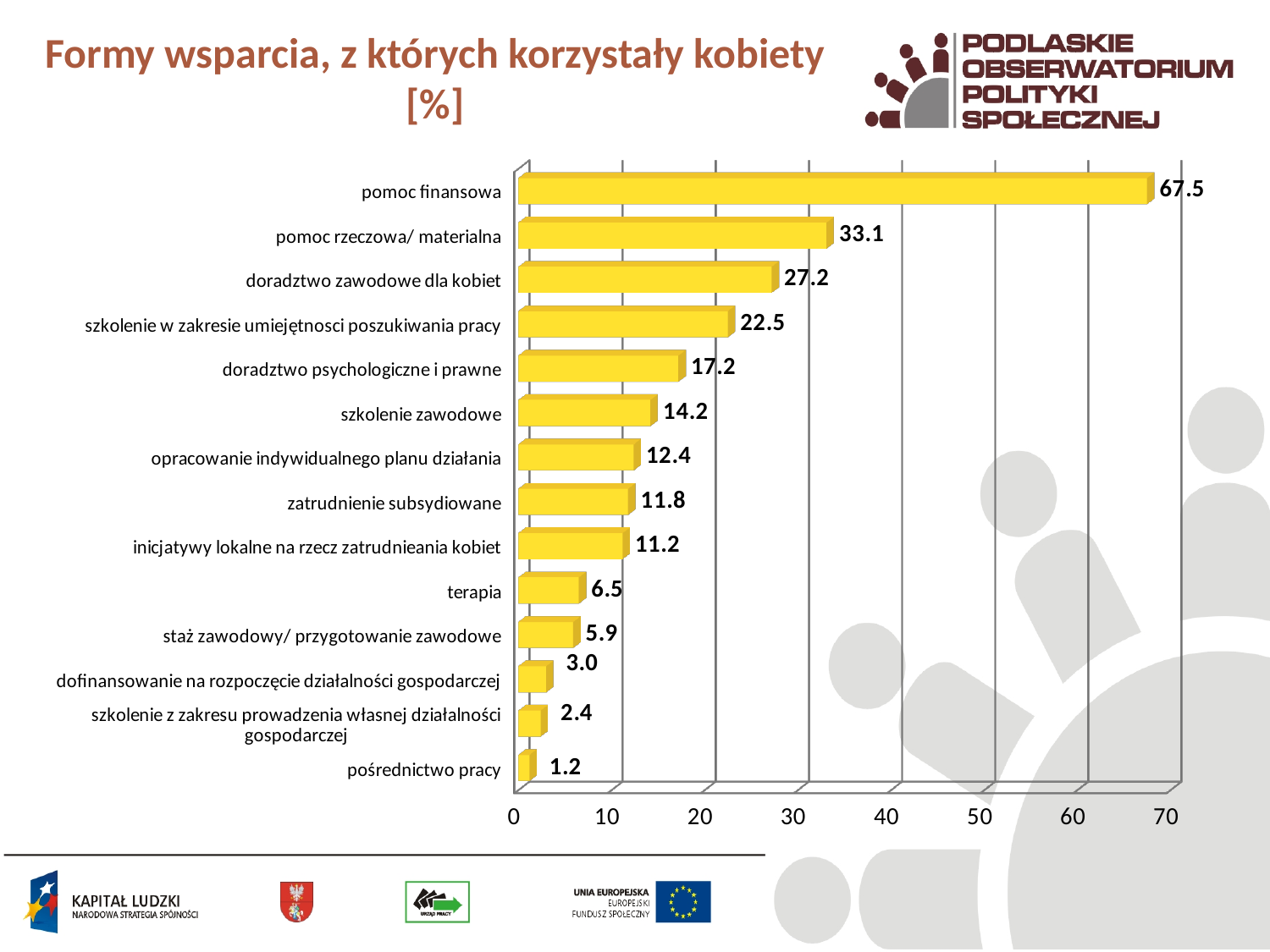
Is the value for "pomoc rzeczowa/ materialna" greater or less than 30? greater What is the value for "staż zawodowy/ przygotowanie zawodowe"? 5.9 Which category has the highest value? pomoc finansowa What is the title of the chart? Formy wsparcia, z których korzystały kobiety [%] What kind of chart is shown on the slide? bar chart What is the difference between the values for "pomoc finansowa" and "pomoc rzeczowa/ materialna"? 34.4 What is the value for "szkolenie zawodowe"? 14.2 Which is larger: the value for "doradztwo zawodowe dla kobiet" or the value for "szkolenie w zakresie umiejętnosci poszukiwania pracy"? doradztwo zawodowe dla kobiet Which category has the lowest value? pośrednictwo pracy What is the value for "pomoc finansowa"? 67.5 How many categories are shown in the chart? 14 What is the value for "terapia"? 6.5